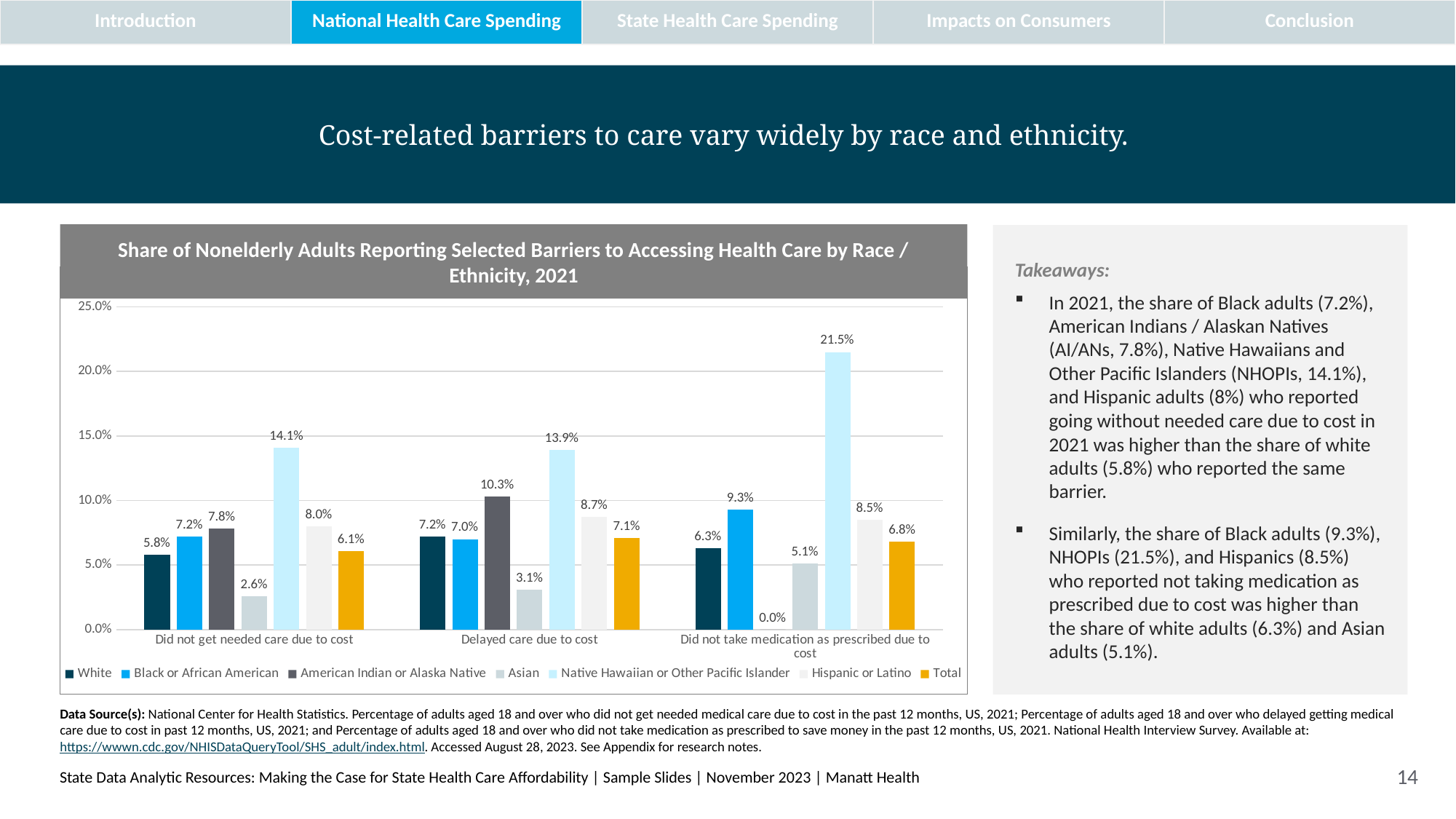
What kind of chart is shown on the slide? Bar chart Which race/ethnicity group has the highest value in the "Did not get needed care due to cost" category? Native Hawaiian or Other Pacific Islander What is the difference between the Black or African American value and the White value in the "Did not take medication as prescribed due to cost" category? 3.0% Is the value for Native Hawaiian or Other Pacific Islander adults in the "Did not take medication as prescribed due to cost" category greater or less than 20.0%? greater Which race/ethnicity group has the lowest value in the "Delayed care due to cost" category? Asian What share of Asian adults reported "Did not get needed care due to cost"? 2.6% How many barrier categories are shown on the x axis? 3 What is the title of the chart? Share of Nonelderly Adults Reporting Selected Barriers to Accessing Health Care by Race / Ethnicity, 2021 How many series does the legend list? 7 What is the value for American Indian or Alaska Native adults in the "Delayed care due to cost" category? 10.3% In the "Delayed care due to cost" category, which is larger: the value for Hispanic or Latino adults or the value for the Total? Hispanic or Latino What is the value for Native Hawaiian or Other Pacific Islander adults in the "Did not take medication as prescribed due to cost" category? 21.5%